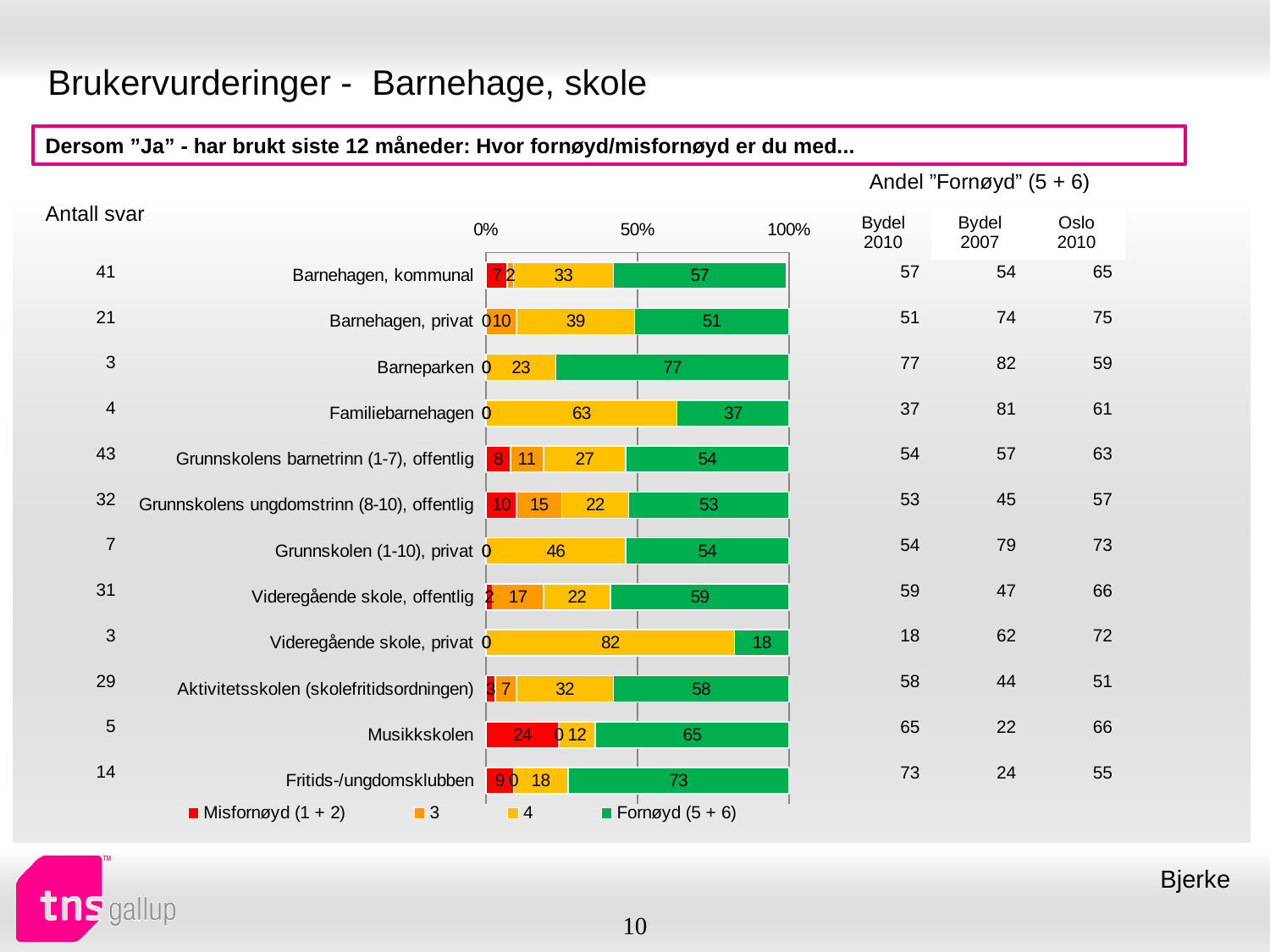
Which category has the highest Fornøyd (5 + 6) value? Barneparken Which has a larger Fornøyd (5 + 6) value, Barnehagen, kommunal or Familiebarnehagen? Barnehagen, kommunal How many categories are shown in the chart? 12 What is the value of series 4 for Videregående skole, privat? 82 What is the Fornøyd (5 + 6) value for Musikkskolen? 65 What is the Fornøyd (5 + 6) value for Barneparken? 77 Which legend entry is shown in green? Fornøyd (5 + 6) What is the difference between the Fornøyd (5 + 6) values for Fritids-/ungdomsklubben and Barnehagen, privat? 22 How many series does the legend list? 4 What kind of chart is shown on the slide? Stacked bar chart Which category has the lowest Fornøyd (5 + 6) value? Videregående skole, privat What is the Misfornøyd (1 + 2) value for Grunnskolens ungdomstrinn (8-10), offentlig? 10